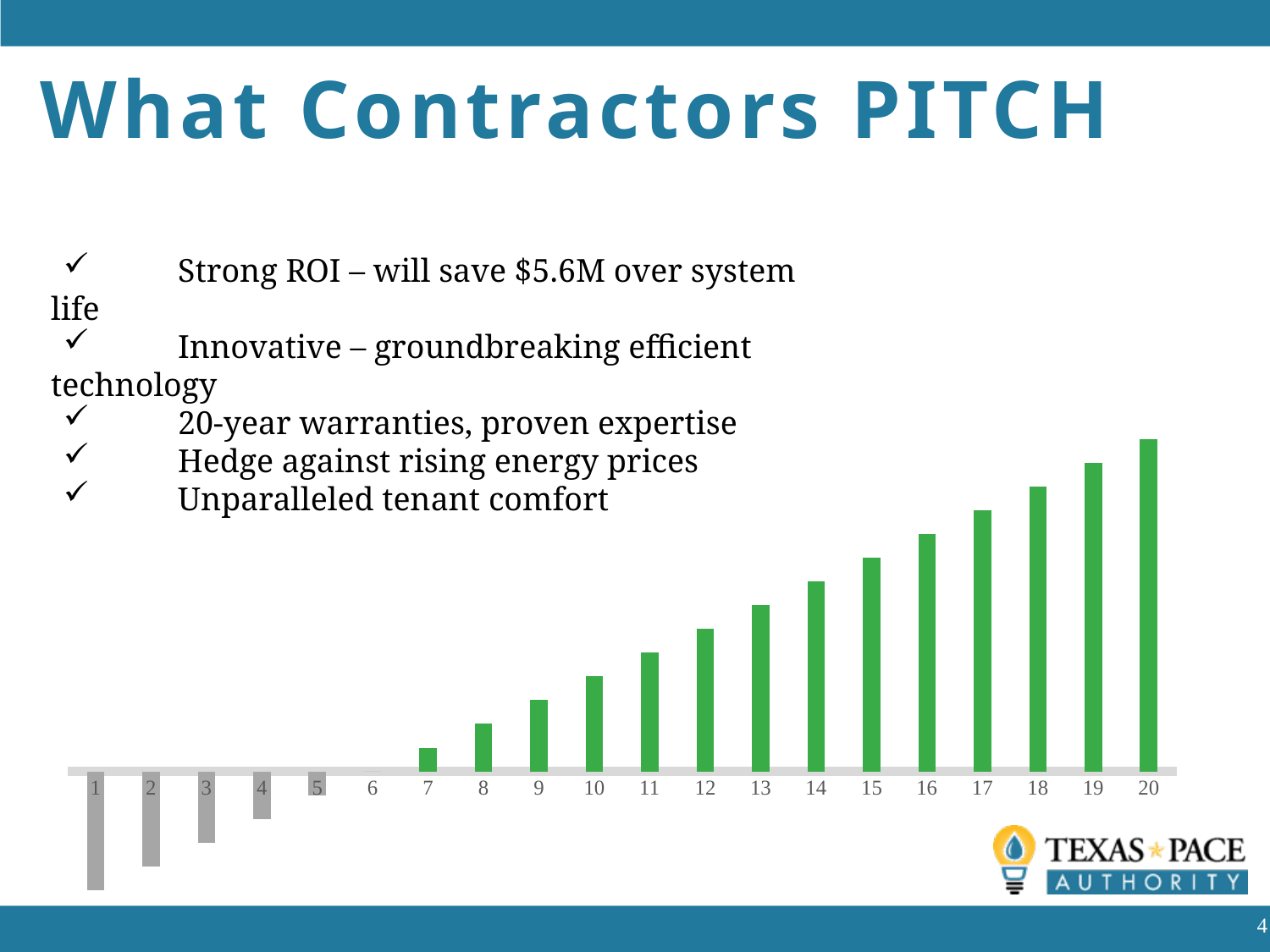
Which category has the lowest (most negative) bar in the chart? 1 Is the bar for category 20 taller than the bar for category 7? yes How many categories are shown along the x axis of the chart? 20 What kind of chart is shown on the slide? bar chart Do the green bars rise or fall as the x axis goes from 7 to 20? rise What colour are the bars that extend above the axis? green Which bar is taller, category 12 or category 18? 18 Which categories have bars extending below the axis? 1 through 5 Which category has no visible bar? 6 Which bar extends further below the axis, category 1 or category 5? 1 Which category has the tallest bar in the chart? 20